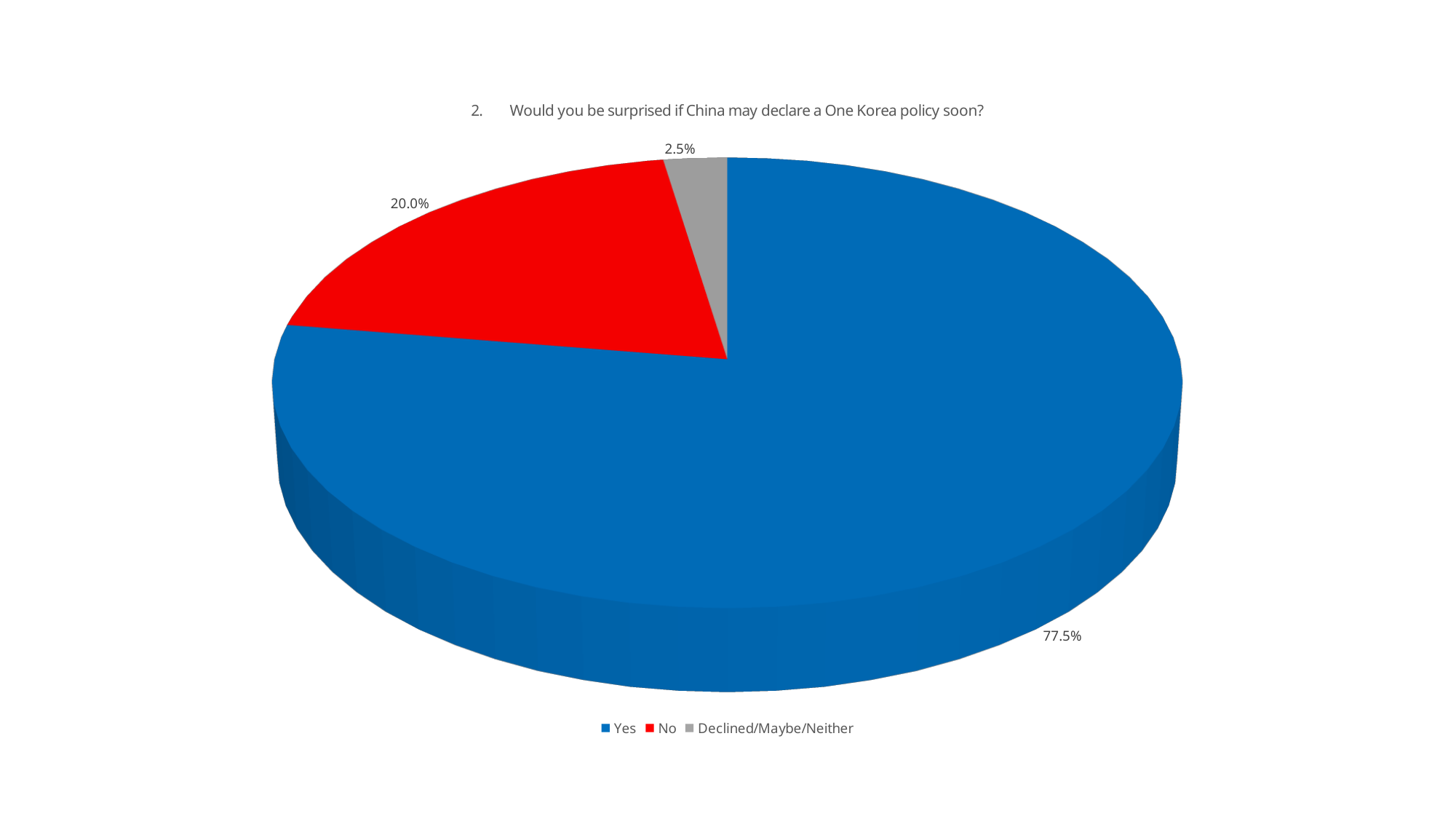
How many categories does the legend list? 3 What kind of chart is shown on the slide? Pie chart Which response has the largest share of the pie? Yes What percentage of respondents answered Yes? 77.5% What percentage of respondents are in the Declined/Maybe/Neither category? 2.5% What is the title of the chart? Would you be surprised if China may declare a One Korea policy soon? What is the combined share of the No and Declined/Maybe/Neither slices? 22.5% Which response has the smallest share of the pie? Declined/Maybe/Neither What is the difference in percentage points between the Yes and No shares? 57.5 Which is larger, the share for No or the share for Declined/Maybe/Neither? No What percentage of respondents answered No? 20.0% What colour represents the No category? Red